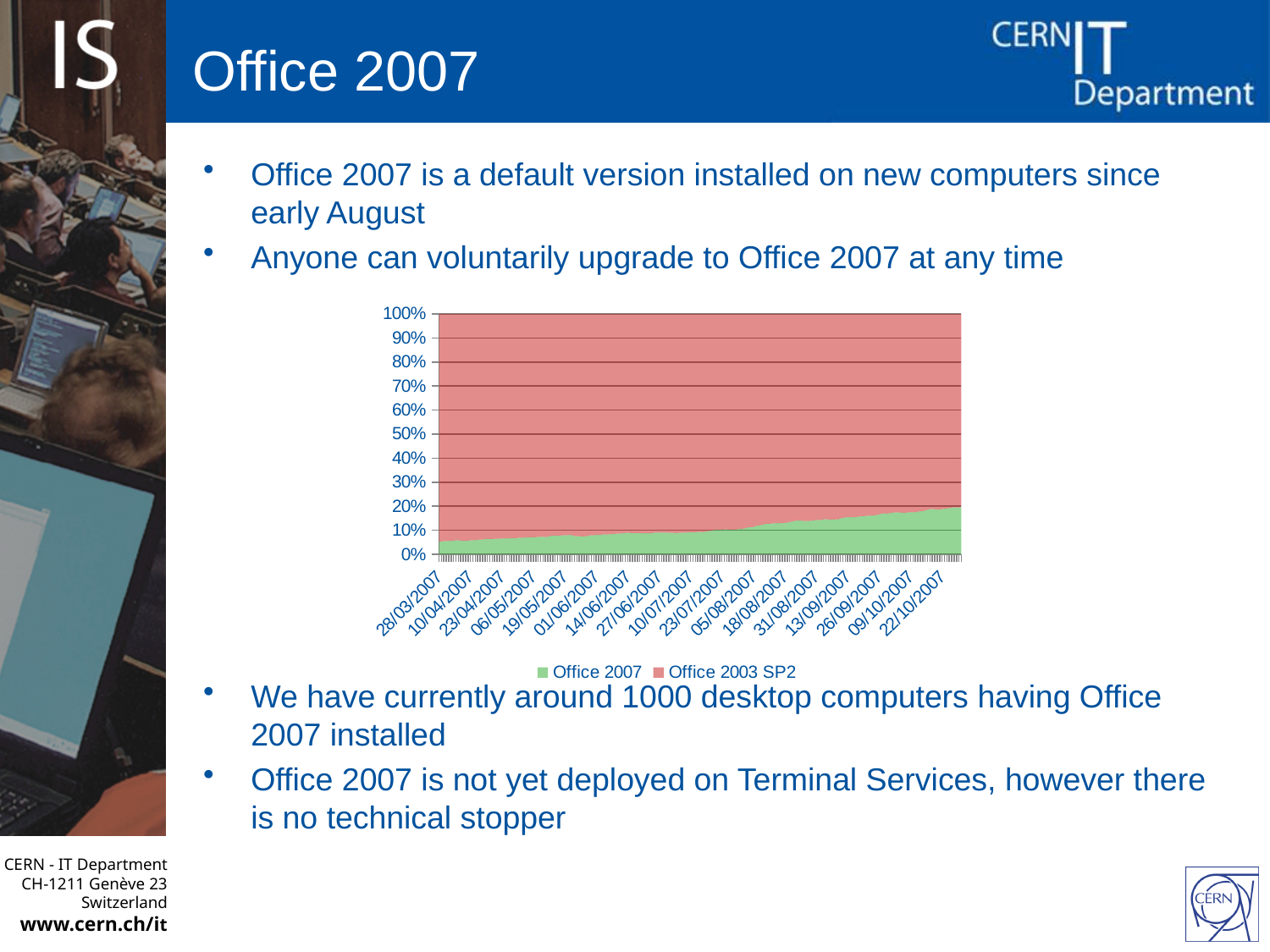
Is the share of Office 2007 at 28/03/2007 greater or less than 10%? less What is the first date label shown on the x axis? 28/03/2007 Does the share of Office 2003 SP2 rise or fall over the period shown? Fall What kind of chart is shown on the slide? Stacked area chart What is the last date label shown on the x axis? 22/10/2007 What colour represents Office 2007 in the chart? Green Is the share of Office 2007 at 22/10/2007 greater or less than 10%? greater Which two series are listed in the chart legend? Office 2007 and Office 2003 SP2 Does the share of Office 2007 rise or fall from 28/03/2007 to 22/10/2007? Rise How many series does the chart legend list? 2 Is the share of Office 2003 SP2 at 28/03/2007 greater or less than 90%? greater At 22/10/2007, which series has the larger share, Office 2007 or Office 2003 SP2? Office 2003 SP2